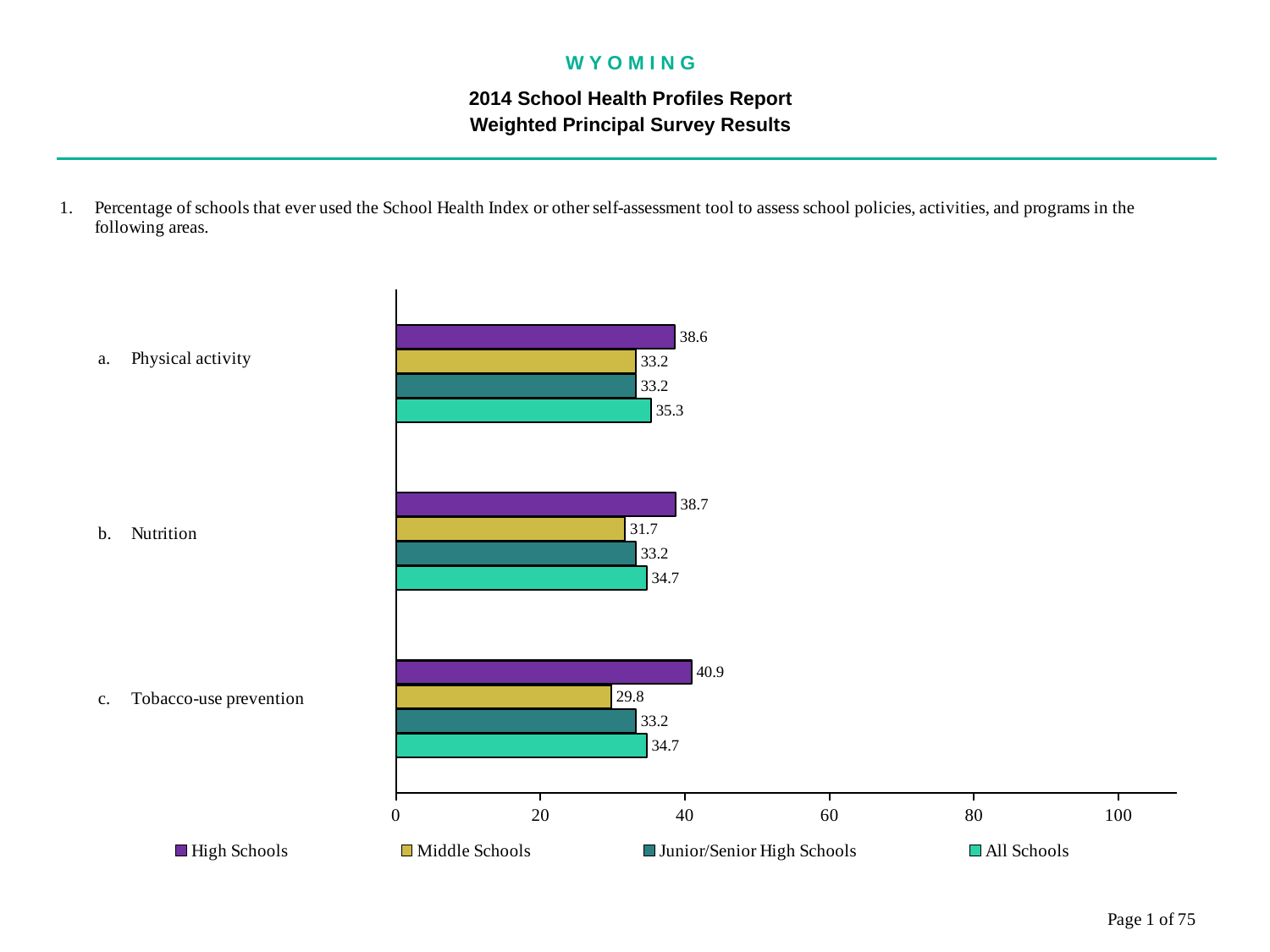
How many series does the legend list? 4 What is the difference between the High Schools and Middle Schools values in the Tobacco-use prevention category? 11.1 What kind of chart is shown on the slide? bar chart What is the value for High Schools in the Physical activity category? 38.6 What is the value for All Schools in the Nutrition category? 34.7 Is the value for High Schools in the Tobacco-use prevention category greater or less than 40? greater Which category has the lowest value for Middle Schools? Tobacco-use prevention How many categories are shown on the chart? 3 What is the value for Middle Schools in the Tobacco-use prevention category? 29.8 What is the value for Junior/Senior High Schools in the Nutrition category? 33.2 Which is larger in the Nutrition category: the High Schools value or the Middle Schools value? High Schools Which category has the highest value for High Schools? Tobacco-use prevention